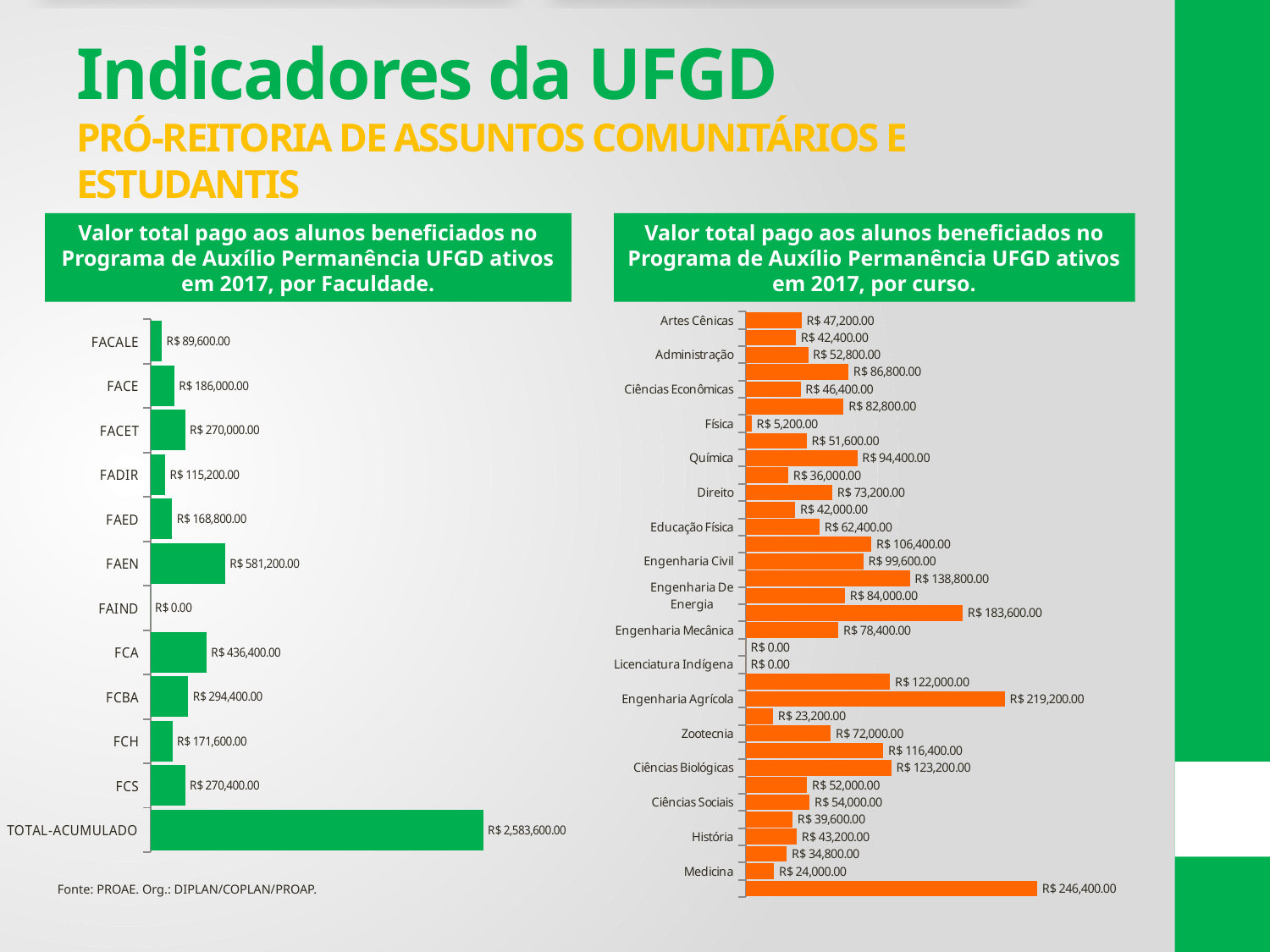
In the chart by Faculdade (left), what is the value for TOTAL-ACUMULADO? R$ 2,583,600.00 In the chart by curso (right), what is the largest value shown? R$ 246,400.00 What kind of chart is the chart by Faculdade (left)? Bar chart In the chart by Faculdade (left), what is the value for FAEN? R$ 581,200.00 In the chart by Faculdade (left), which faculdade has the lowest value? FAIND In the chart by curso (right), what is the value for Artes Cênicas? R$ 47,200.00 How many bars are shown in the chart by Faculdade (left)? 12 In the chart by Faculdade (left), excluding TOTAL-ACUMULADO, which faculdade has the highest value? FAEN In the chart by Faculdade (left), what is the value for FCA? R$ 436,400.00 In the chart by Faculdade (left), which is larger, the value for FCBA or the value for FCH? FCBA In the chart by curso (right), what is the value for Física? R$ 5,200.00 In the chart by Faculdade (left), what is the difference between the values for FACET and FACE? R$ 84,000.00